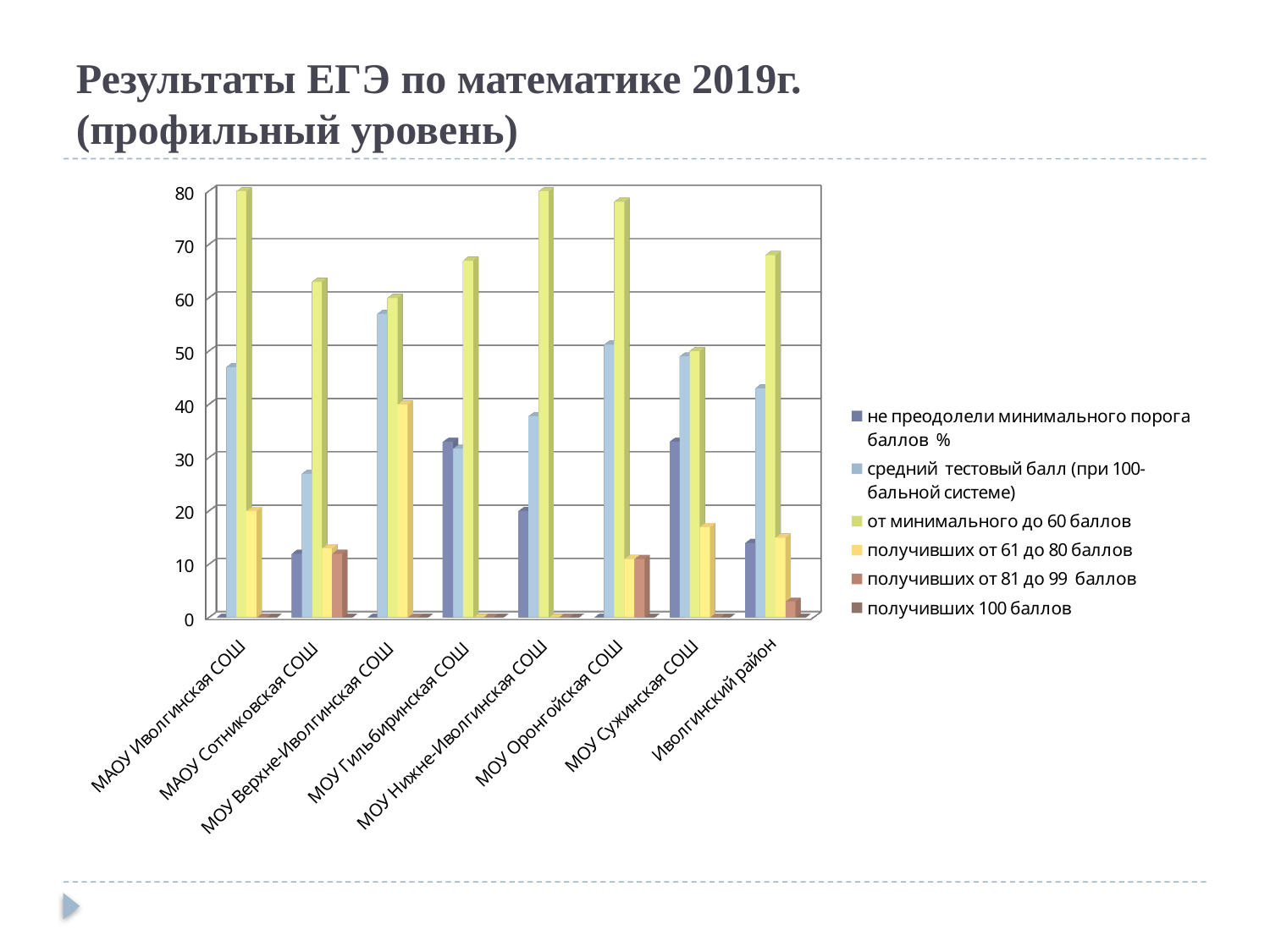
How many series does the legend list? 6 Which category has the highest "средний тестовый балл (при 100-бальной системе)"? МОУ Верхне-Иволгинская СОШ Which has the larger "не преодолели минимального порога баллов %": МОУ Гильбиринская СОШ or МОУ Нижне-Иволгинская СОШ? МОУ Гильбиринская СОШ Is the value of "получивших от 61 до 80 баллов" for МОУ Верхне-Иволгинская СОШ greater or less than 30? greater Which has the larger "средний тестовый балл (при 100-бальной системе)": МОУ Верхне-Иволгинская СОШ or МОУ Нижне-Иволгинская СОШ? МОУ Верхне-Иволгинская СОШ Is the value of "не преодолели минимального порога баллов %" for Иволгинский район greater or less than 20? less What kind of chart is shown on the slide? bar chart What is the title of the slide containing the chart? Результаты ЕГЭ по математике 2019г. (профильный уровень) Which category has the lowest "средний тестовый балл (при 100-бальной системе)"? МАОУ Сотниковская СОШ Is the value of "от минимального до 60 баллов" for МАОУ Иволгинская СОШ greater or less than 70? greater How many schools/categories are shown along the x axis? 8